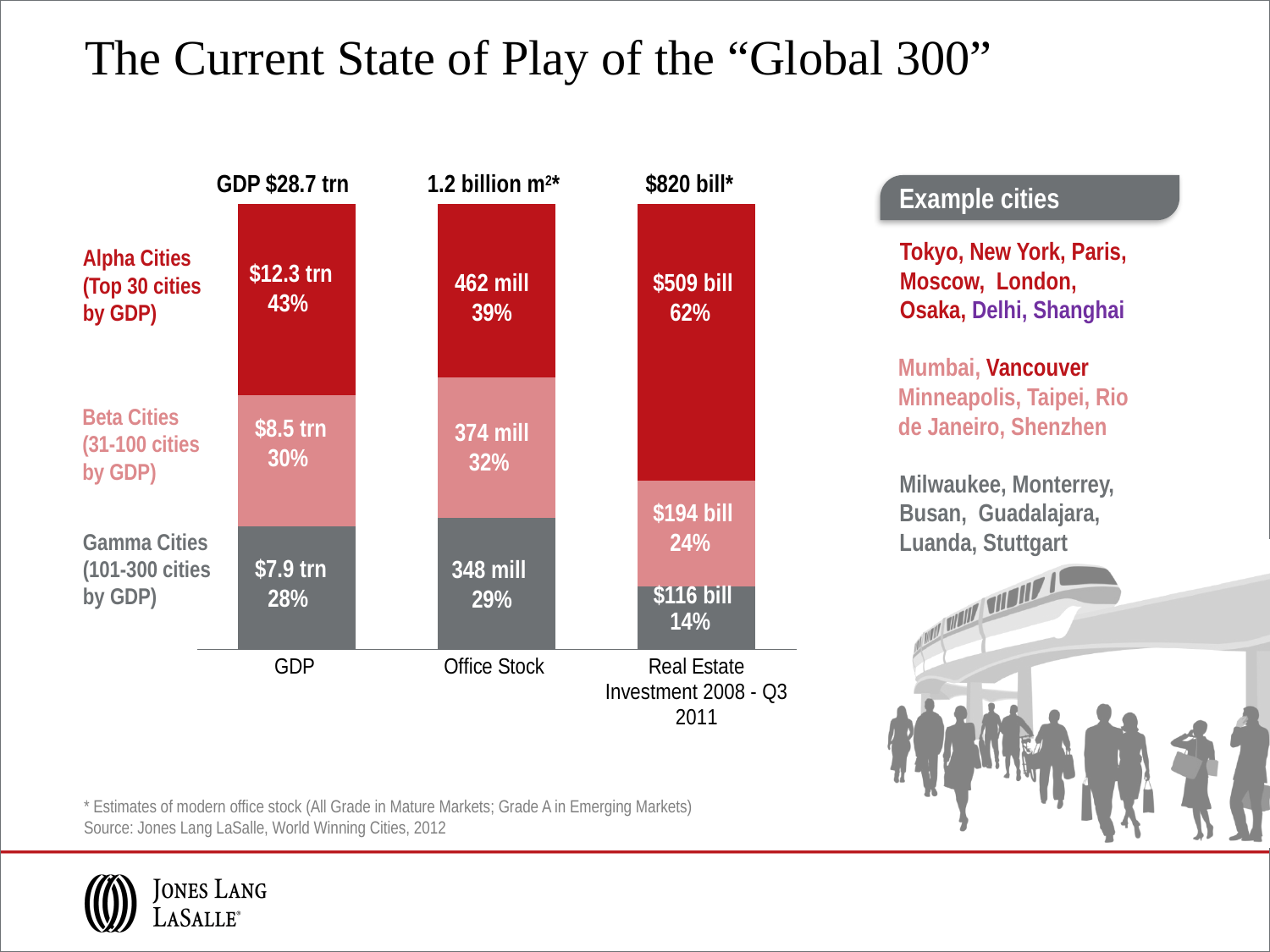
Which city tier has the smallest share of Real Estate Investment 2008 - Q3 2011? Gamma Cities What is the total Real Estate Investment 2008 - Q3 2011 shown above that bar? $820 bill What is the total GDP shown above the GDP bar? $28.7 trn How many bars (categories) does the chart show? 3 Which is larger: the Office Stock of Beta Cities or of Gamma Cities? Beta Cities How many city tiers (series) are stacked in each bar? 3 What is the Real Estate Investment 2008 - Q3 2011 value for Gamma Cities? $116 bill What share of Office Stock is held by Beta Cities? 32% In which category do Alpha Cities have their largest percentage share? Real Estate Investment 2008 - Q3 2011 What is the GDP value for Alpha Cities? $12.3 trn What kind of chart is shown on the slide? Stacked bar chart What is the difference between the Alpha Cities and Gamma Cities GDP values? $4.4 trn